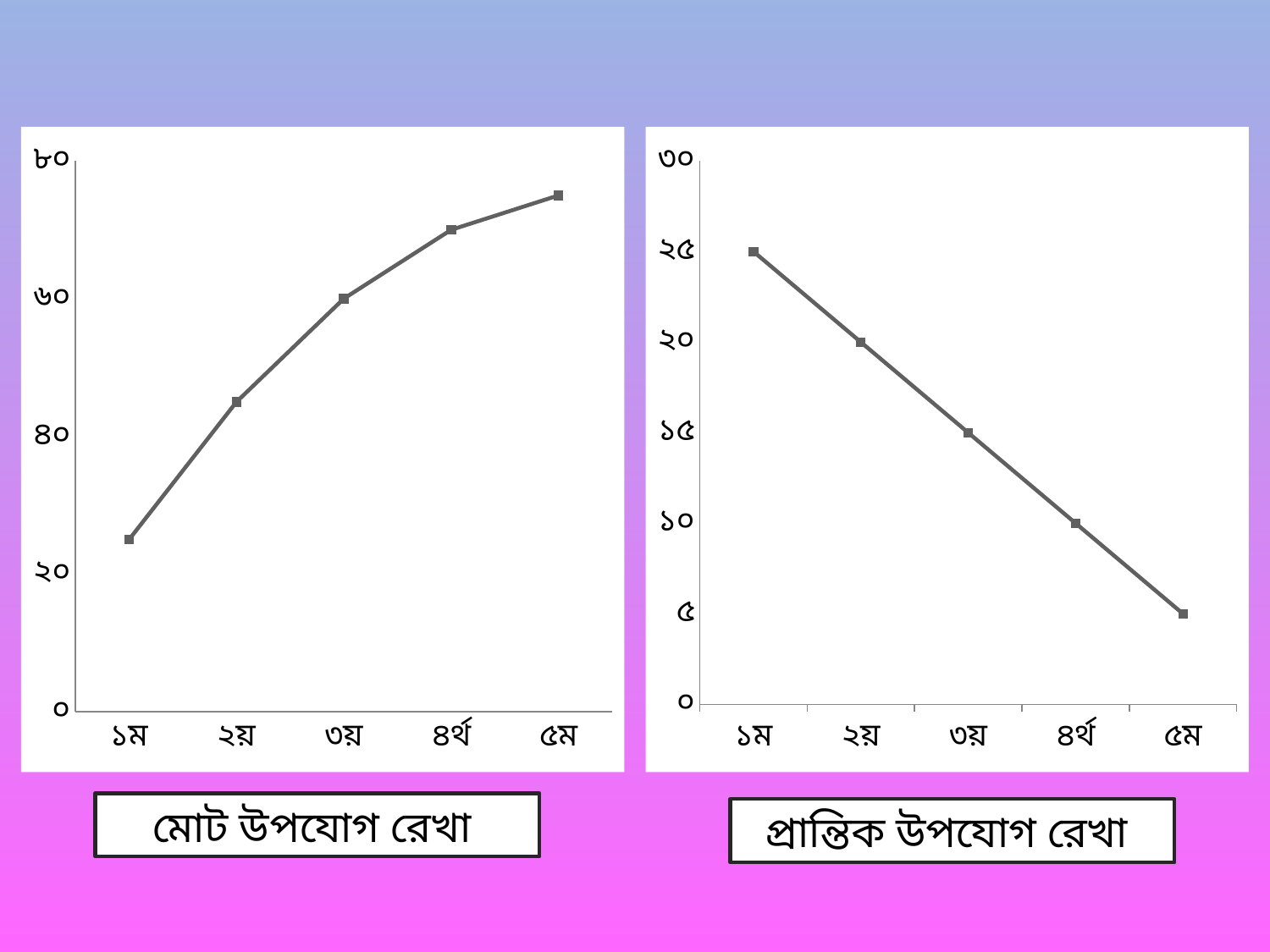
In the right chart (প্রান্তিক উপযোগ রেখা), which category has the lowest value? ৫ম How many points are plotted on the right chart (প্রান্তিক উপযোগ রেখা)? 5 In the left chart (মোট উপযোগ রেখা), do the values rise or fall from ১ম to ৫ম? rise In the right chart (প্রান্তিক উপযোগ রেখা), what is the value for ১ম? ২৫ What kind of chart is the right chart titled প্রান্তিক উপযোগ রেখা? line chart What kind of chart is the left chart titled মোট উপযোগ রেখা? line chart In the right chart (প্রান্তিক উপযোগ রেখা), what is the value for ৩য়? ১৫ In the right chart (প্রান্তিক উপযোগ রেখা), what is the difference between the values for ১ম and ৫ম? ২০ In the left chart (মোট উপযোগ রেখা), is the value for ১ম greater or less than ৪০? less In the left chart (মোট উপযোগ রেখা), which category has the highest value? ৫ম In the right chart (প্রান্তিক উপযোগ রেখা), what is the value for ৫ম? ৫ In the right chart (প্রান্তিক উপযোগ রেখা), do the values rise or fall from ১ম to ৫ম? fall